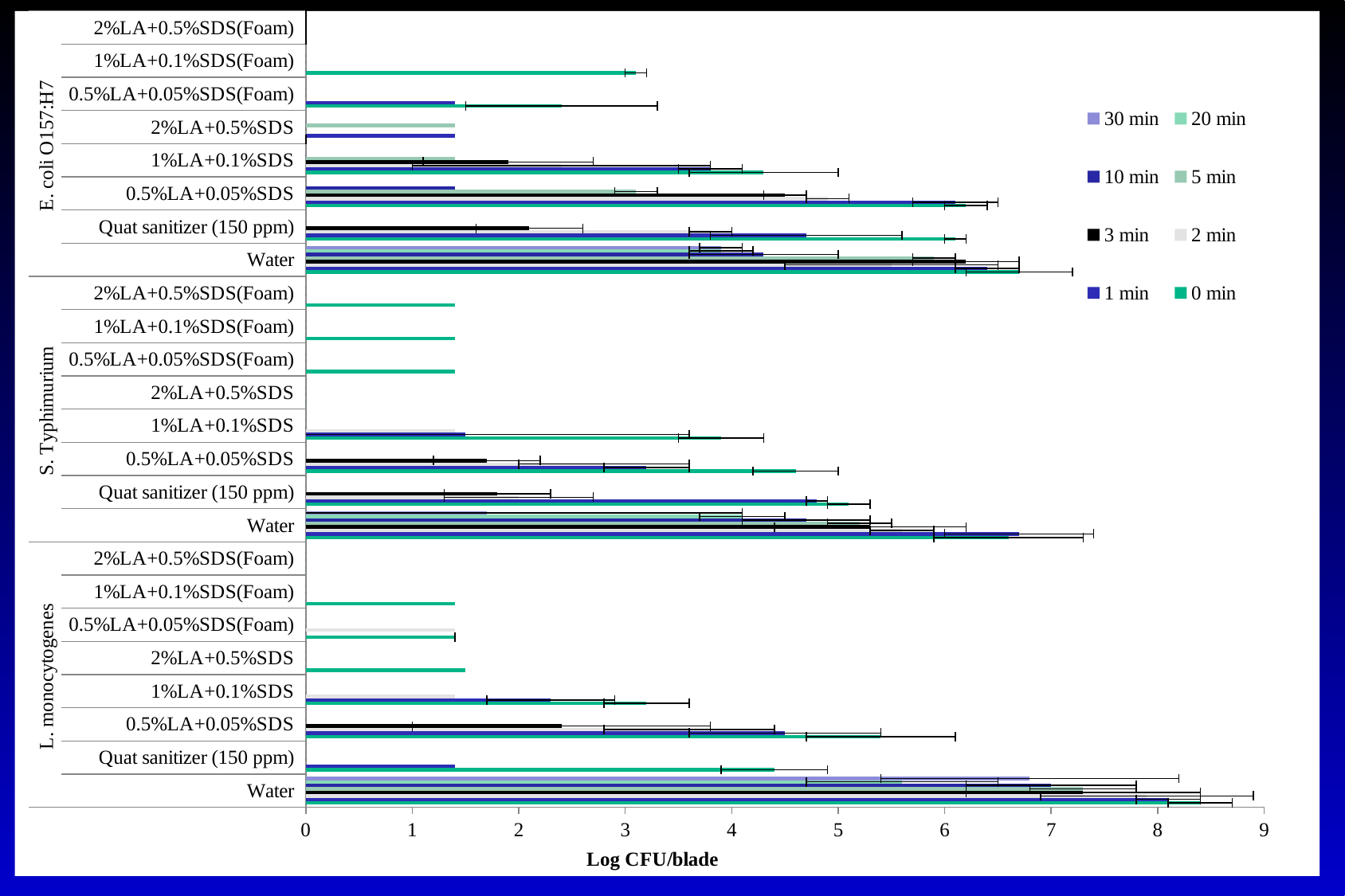
How many organism groups are shown on the y axis? 3 Which is larger: the 0 min value for Water in the L. monocytogenes group or the 0 min value for Water in the E. coli O157:H7 group? L. monocytogenes What is the title of the x axis? Log CFU/blade What is the highest value shown on the x axis? 9 How many treatment categories are listed for E. coli O157:H7? 8 Is the 0 min value for Water in the L. monocytogenes group greater or less than 7? greater Which organism group has the highest 0 min value for Water? L. monocytogenes Is the 0 min value for 2%LA+0.5%SDS(Foam) in the S. Typhimurium group greater or less than 2? less Is the 0 min value for Water in the E. coli O157:H7 group greater or less than 6? greater How many series does the legend list? 8 What kind of chart is shown on the slide? bar chart